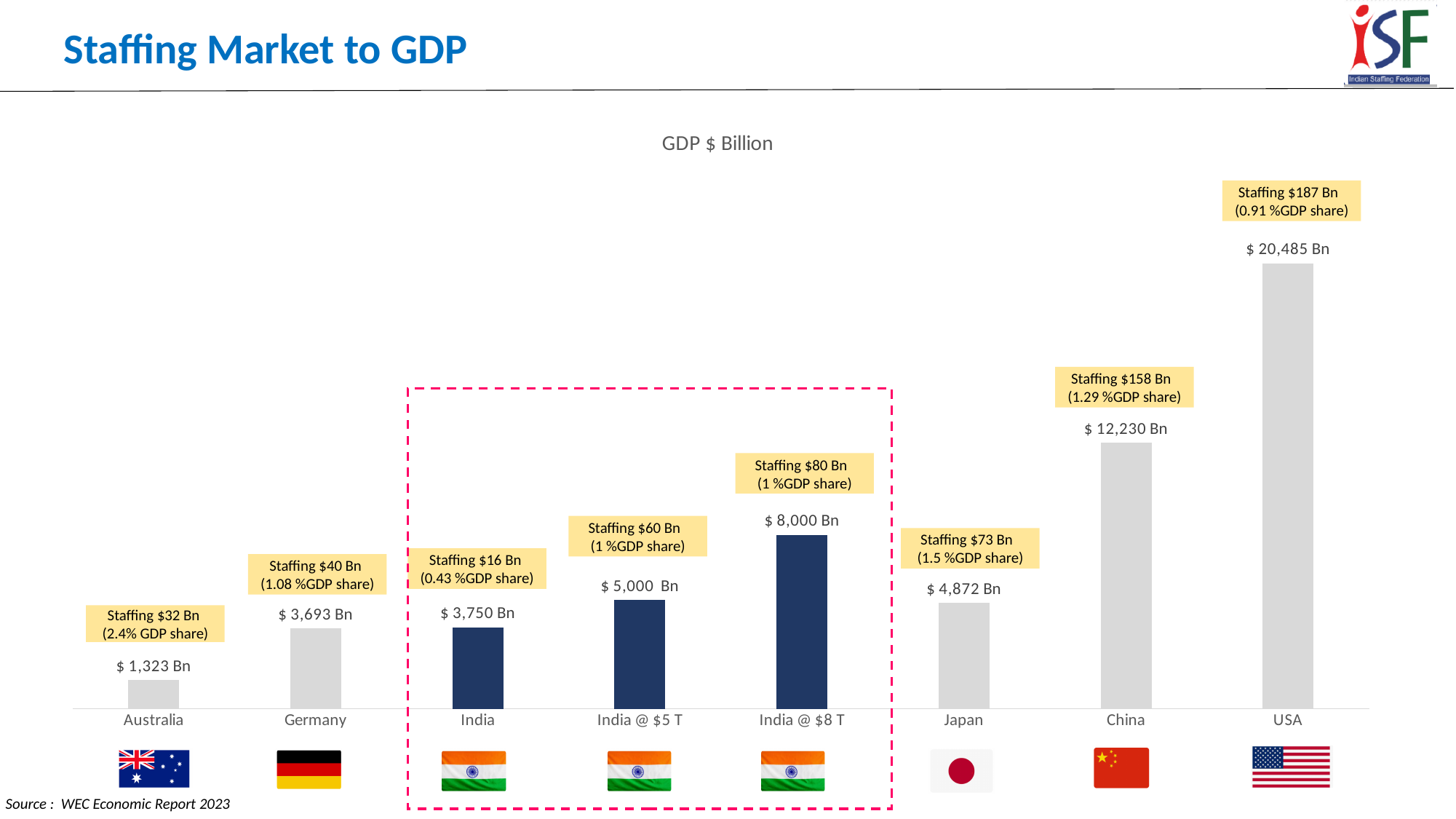
What is the GDP value shown for USA? $ 20,485 Bn Which category has the lowest GDP bar? Australia What is the title of the chart? GDP $ Billion How many categories are shown on the x axis? 8 Which has a larger GDP value, Germany or India? India What is the GDP value shown for India @ $5 T? $ 5,000 Bn What GDP share is shown in the staffing label for Australia? 2.4% What kind of chart is shown on the slide? Bar chart What is the staffing market value shown in the label for China? Staffing $158 Bn What is the GDP value shown for Germany? $ 3,693 Bn Which category has the highest GDP bar? USA What is the difference between the GDP values for China and Japan? $ 7,358 Bn